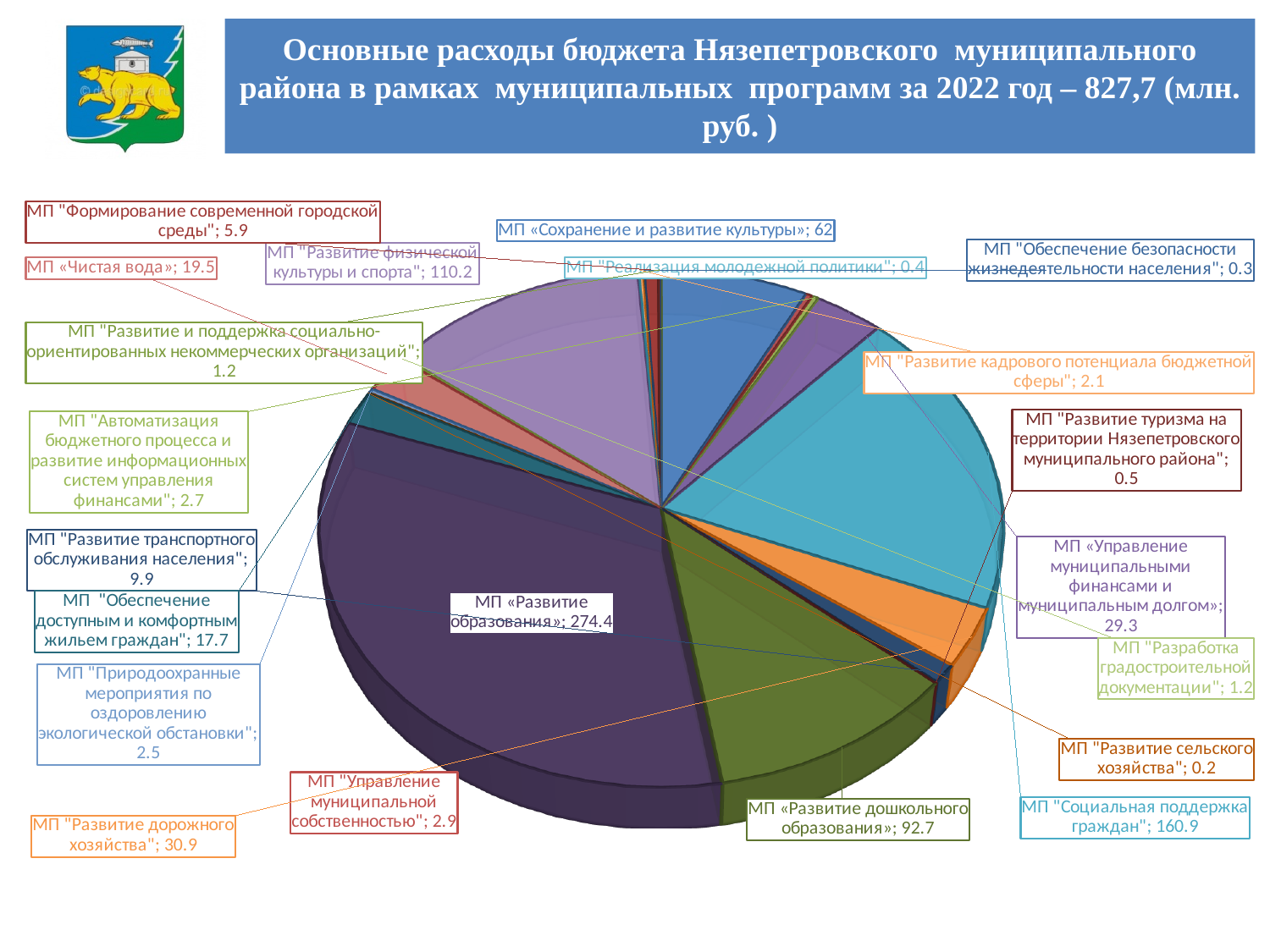
According to the slide title, what is the total of the main budget expenditures under municipal programs for 2022? 827,7 (млн. руб.) What is the difference between the values for МП "Развитие дорожного хозяйства" and МП «Управление муниципальными финансами и муниципальным долгом»? 1.6 How many programs (slices) are labelled in the pie chart? 21 Which program has the largest slice of the pie chart? МП «Развитие образования» What kind of chart is shown on the slide? pie chart Which program has the smallest value in the pie chart? МП "Развитие сельского хозяйства" What is the value shown for МП "Развитие физической культуры и спорта"? 110.2 What is the value shown for МП "Социальная поддержка граждан"? 160.9 What is the value shown for МП «Чистая вода»? 19.5 What is the value shown for МП «Развитие дошкольного образования»? 92.7 Which is larger: the value for МП «Сохранение и развитие культуры» or the value for МП «Развитие дошкольного образования»? МП «Развитие дошкольного образования» What is the difference between the values for МП «Развитие образования» and МП "Социальная поддержка граждан"? 113.5